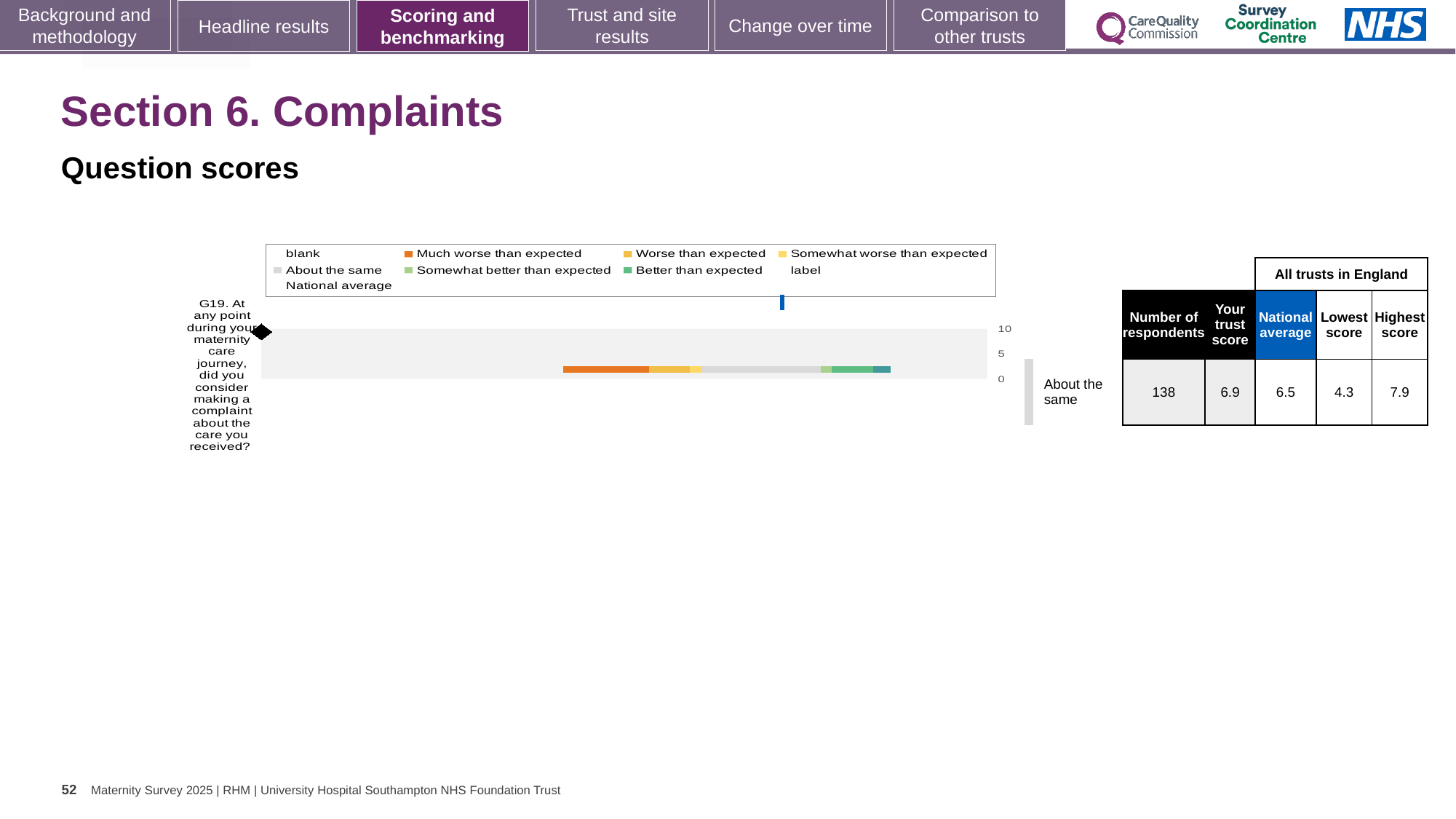
What is the national average shown for G19 in the table next to the chart? 6.5 What benchmark category label is shown to the right of the chart for G19? About the same What is the difference between the highest score and the lowest score shown for G19? 3.6 What kind of chart is shown on the slide? bar chart What is the highest score among all trusts in England shown for G19? 7.9 What is the lowest score among all trusts in England shown for G19? 4.3 How many question categories are plotted in the chart? 1 Which question is plotted in the chart? G19. At any point during your maternity care journey, did you consider making a complaint about the care you received? Is the trust score for G19 larger or smaller than the national average? larger What is the highest tick value shown on the chart's axis? 10 How many respondents are shown for G19 in the table next to the chart? 138 What is the trust score shown for G19 in the table next to the chart? 6.9